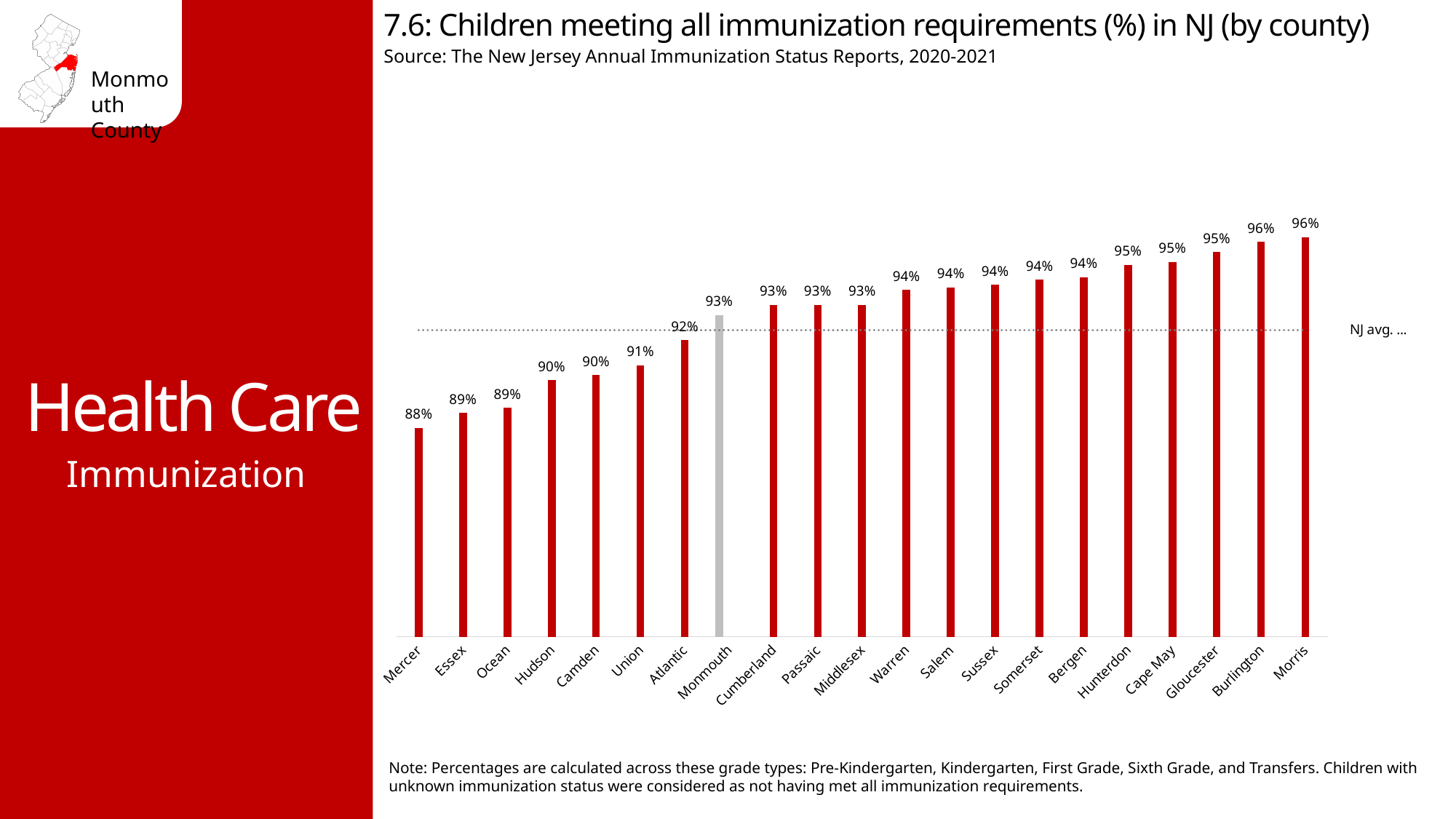
Which has a higher value, Monmouth or Atlantic? Monmouth What is the value shown for Mercer County? 88% What is the difference between Monmouth County's value and Mercer County's value? 5 percentage points What is the difference in percentage points between Morris County and Mercer County? 8 percentage points How many counties are shown on the chart? 21 What kind of chart is shown on the slide? Bar chart What percentage is shown for Hunterdon County? 95% What is the highest percentage shown on the chart? 96% What percentage of children in Monmouth County met all immunization requirements? 93% Which county has the lowest percentage of children meeting all immunization requirements? Mercer Do the values rise or fall moving from left to right along the x axis? Rise What is the value for Atlantic County? 92%